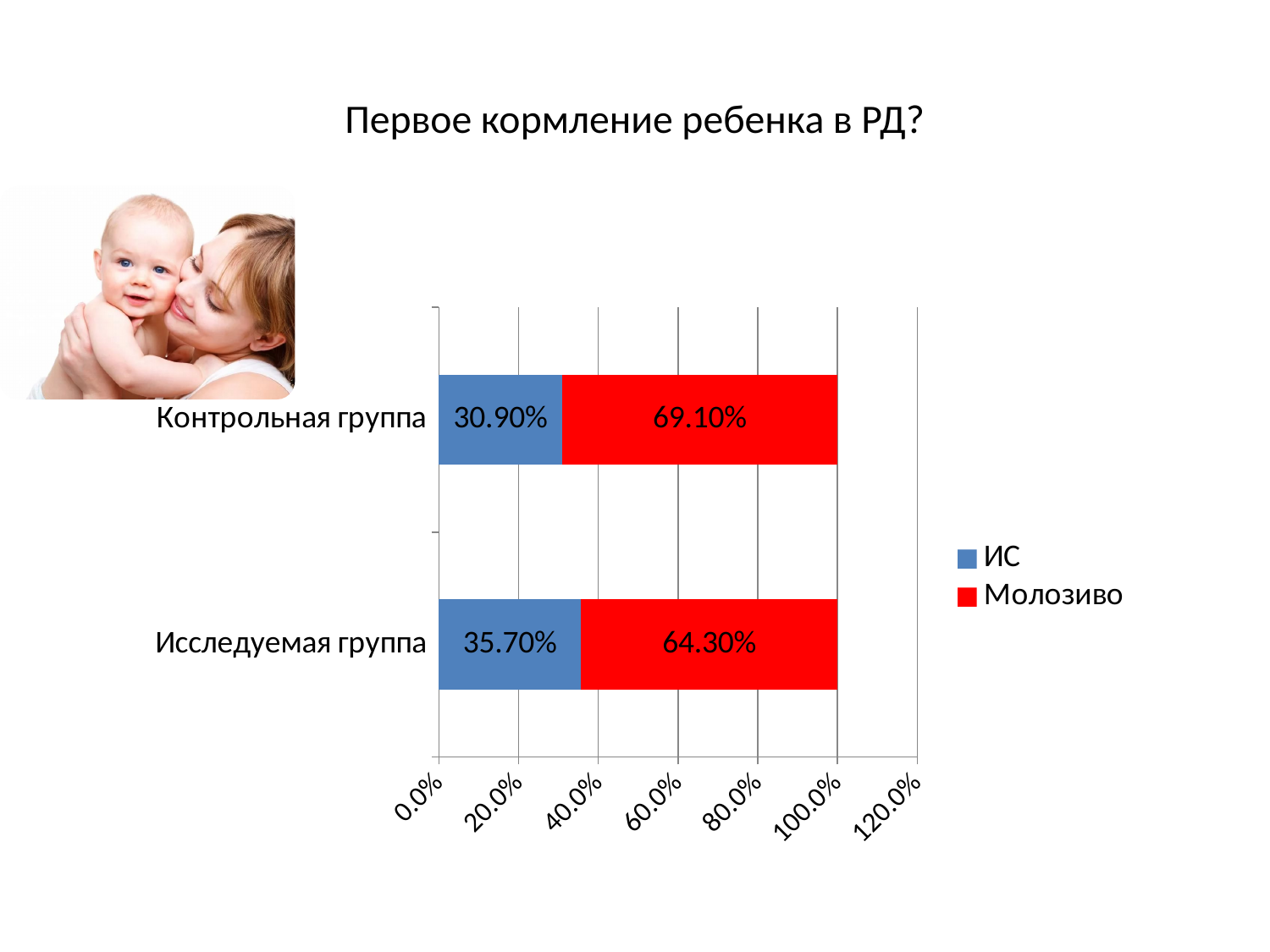
What is the value for ИС in the Контрольная группа? 30.90% What is the total of the stacked bar for the Контрольная группа? 100.00% Which group has the lower value for Молозиво? Исследуемая группа What is the difference between the Молозиво values of the Контрольная группа and the Исследуемая группа? 4.80% Which group has the higher value for ИС? Исследуемая группа Which is larger: ИС in the Контрольная группа or ИС in the Исследуемая группа? ИС in the Исследуемая группа What is the value for ИС in the Исследуемая группа? 35.70% How many groups (categories) are shown in the chart? 2 What is the value for Молозиво in the Контрольная группа? 69.10% What is the value for Молозиво in the Исследуемая группа? 64.30% What kind of chart is shown on the slide? Stacked bar chart How many series does the legend list? 2